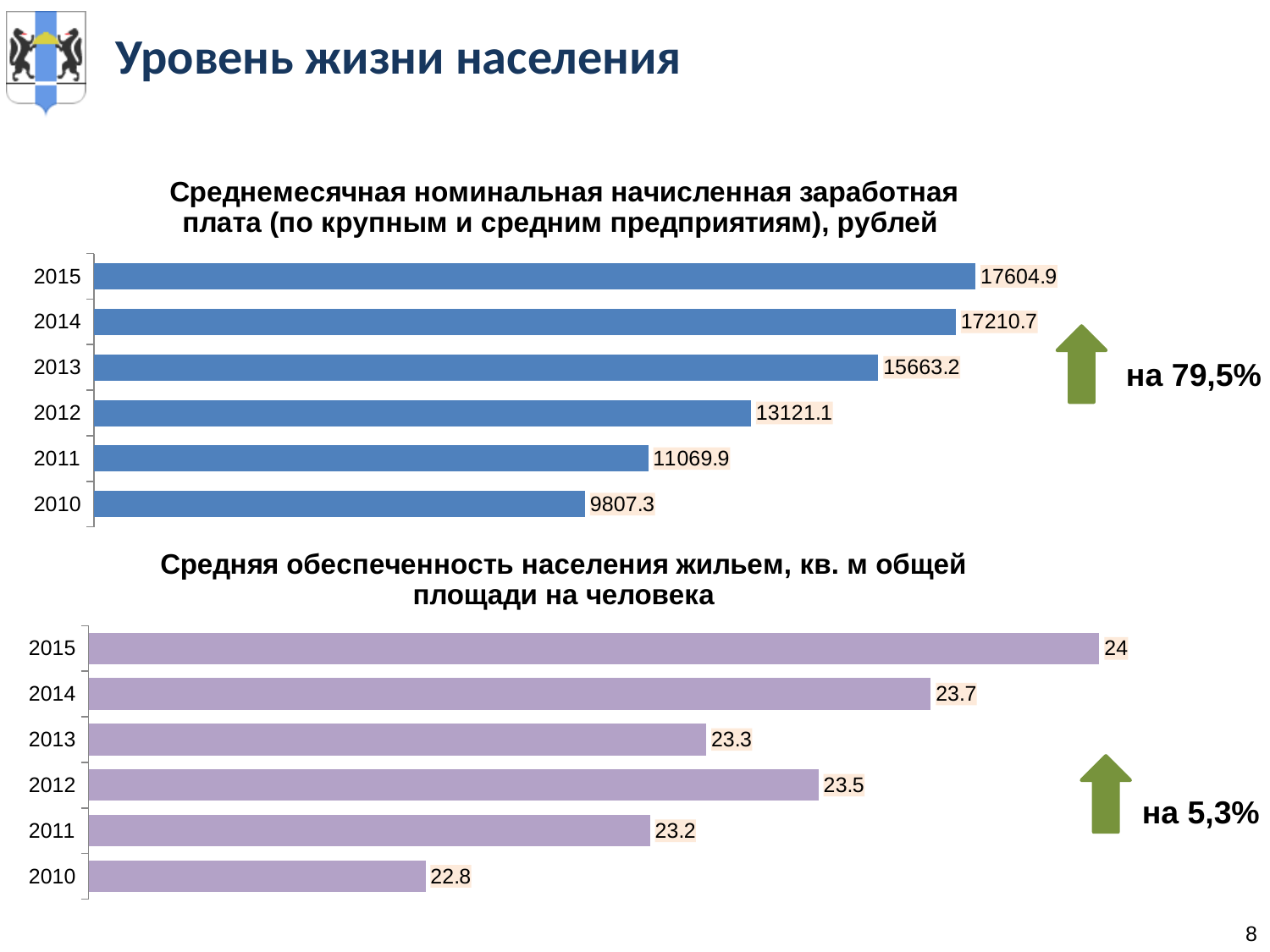
What percentage increase is shown next to the green arrow beside the top chart? на 79,5% In the top chart (average monthly nominal wage), how many years are shown? 6 In the bottom chart (average housing provision per person), what is the difference between the 2015 and 2010 values? 1.2 In the top chart (average monthly nominal wage), what is the value for 2010? 9807.3 In the top chart (average monthly nominal wage), what is the difference between the 2015 and 2010 values? 7797.6 What type of chart is the bottom chart (average housing provision per person)? bar chart In the top chart (average monthly nominal wage), what is the value for 2015? 17604.9 In the bottom chart (average housing provision per person), which is larger: the value for 2012 or the value for 2013? 2012 In the bottom chart (average housing provision per person), what is the value for 2014? 23.7 In the bottom chart (average housing provision per person), which year has the highest value? 2015 In the top chart (average monthly nominal wage), do the values rise or fall from 2010 to 2015? rise In the top chart (average monthly nominal wage), which year has the lowest value? 2010